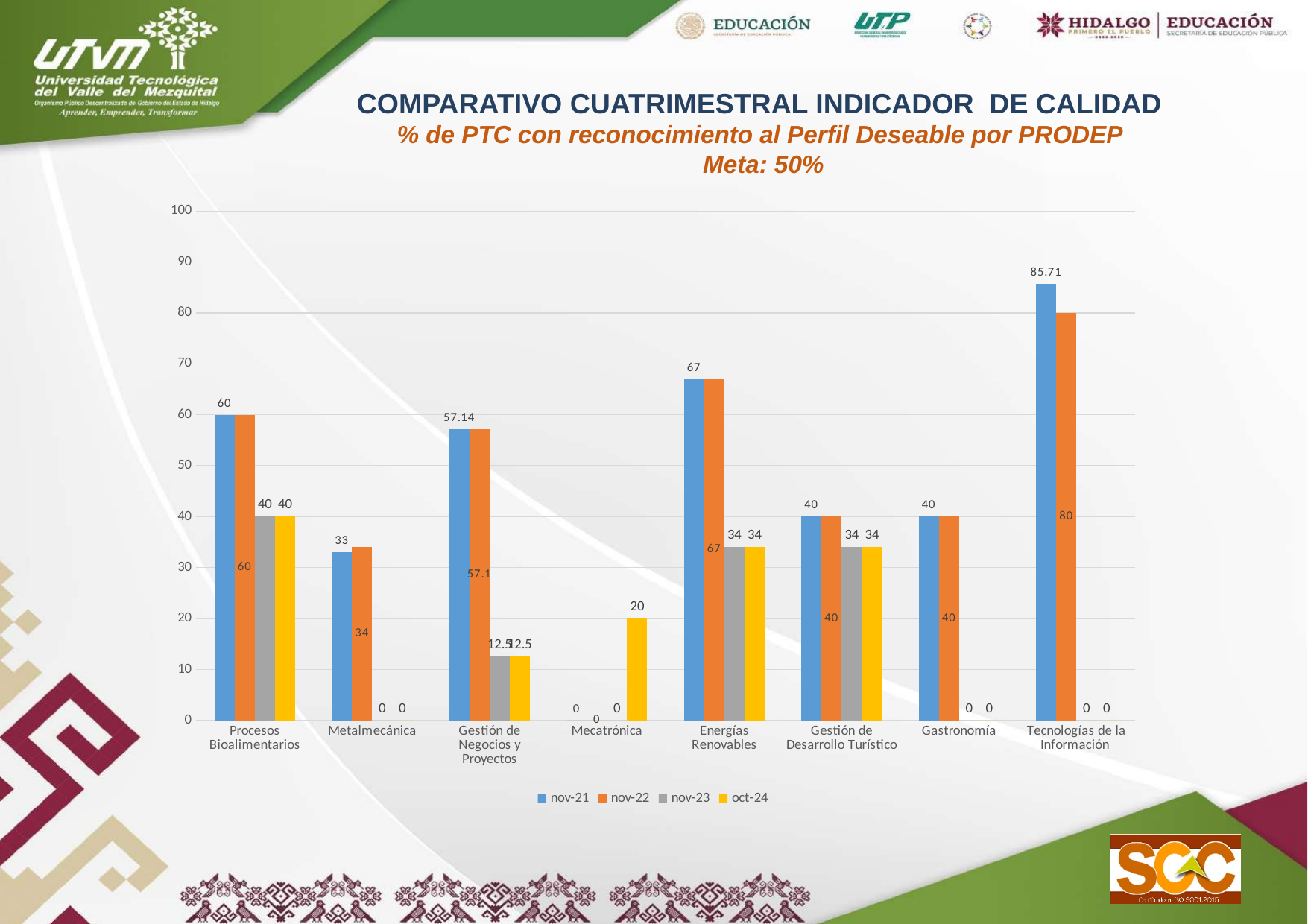
Which category has the highest nov-21 value? Tecnologías de la Información What is the oct-24 value for Mecatrónica? 20 What is the nov-23 value for Gestión de Negocios y Proyectos? 12.5 What is the difference between the nov-21 and nov-22 values for Tecnologías de la Información? 5.71 What is the difference between the nov-21 and oct-24 values for Energías Renovables? 33 How many series does the legend list? 4 Is the nov-22 value for Tecnologías de la Información greater or less than 70? greater Which category has the highest oct-24 value? Procesos Bioalimentarios Which is larger: the nov-21 value for Energías Renovables or the nov-21 value for Procesos Bioalimentarios? Energías Renovables How many categories are shown on the x axis? 8 What kind of chart is shown on the slide? bar chart What is the nov-21 value for Tecnologías de la Información? 85.71